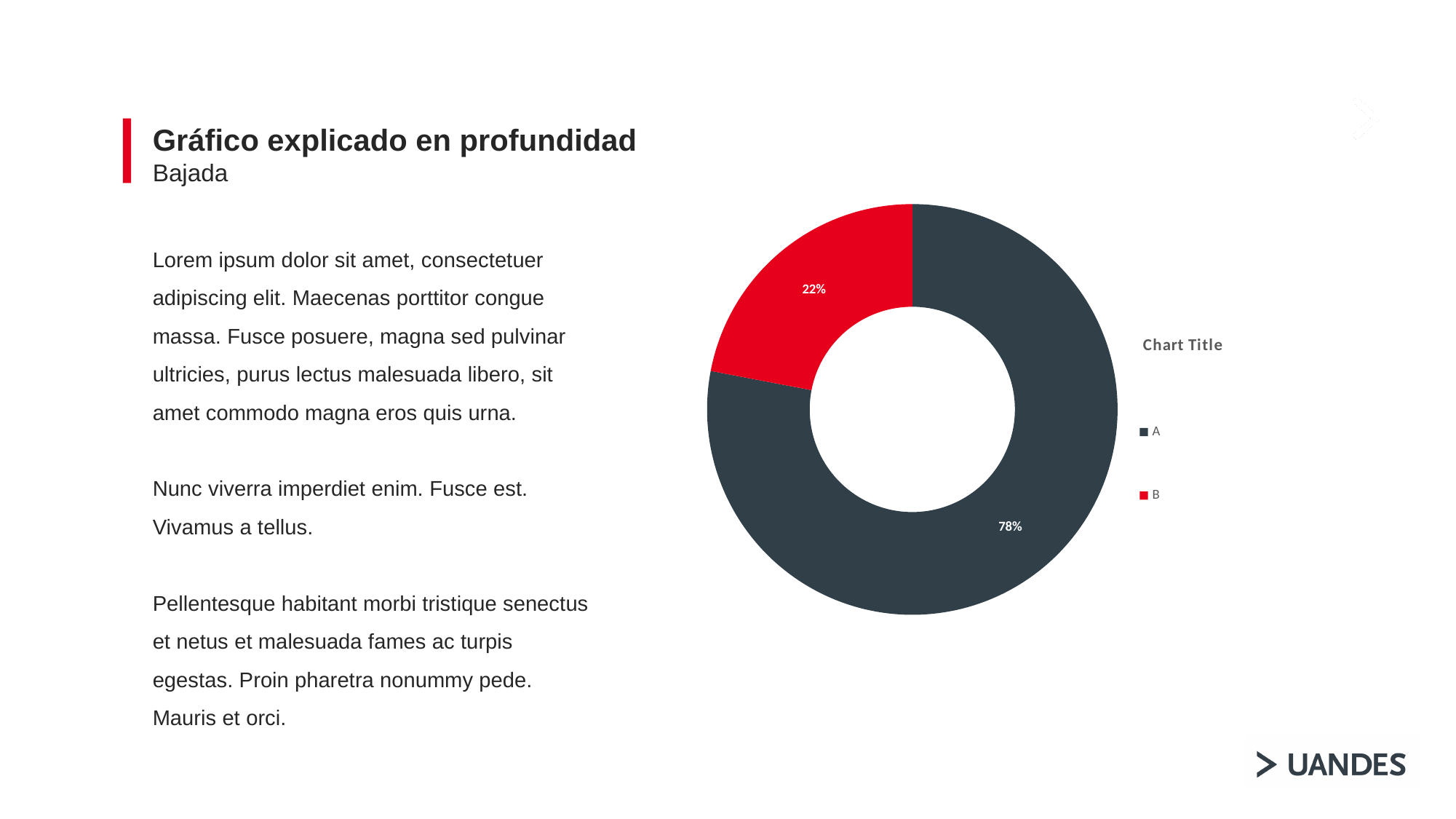
How many categories does the chart show? 2 What is the title of the chart? Chart Title What is the value shown for category B? 22% Which is larger, the value for A or the value for B? A What share of the chart does category A represent? 78% What is the difference between the values for A and B? 56% What colour is the slice for category B? Red What kind of chart is shown on the slide? Doughnut chart Which category has the largest share of the chart? A What is the value shown for category A? 78% How many entries does the legend list? 2 Which category has the smallest share of the chart? B